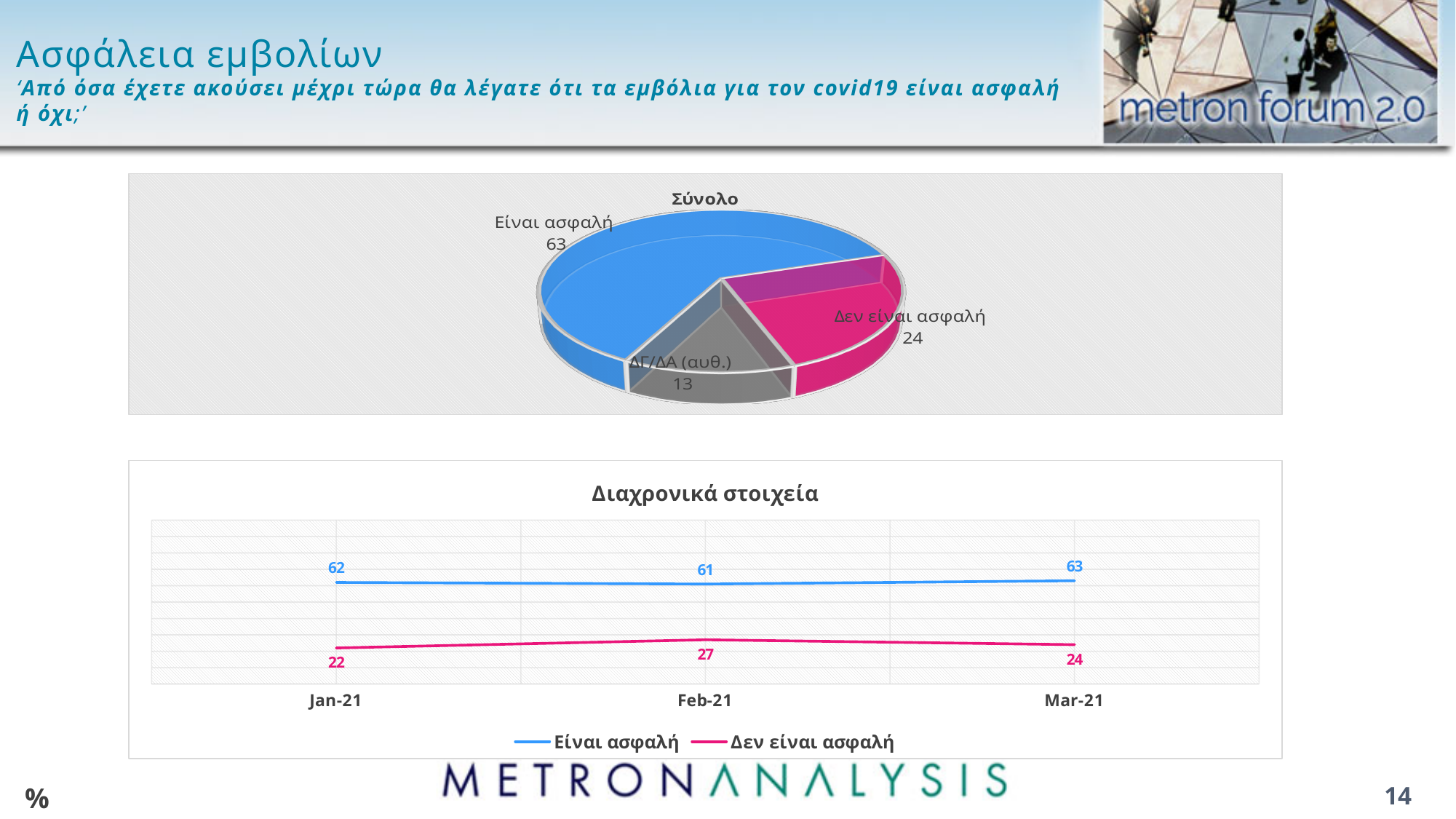
In the chart titled 'Διαχρονικά στοιχεία', what is the value for 'Δεν είναι ασφαλή' in Jan-21? 22 In the chart titled 'Διαχρονικά στοιχεία', what is the difference between 'Είναι ασφαλή' and 'Δεν είναι ασφαλή' in Mar-21? 39 In the chart titled 'Διαχρονικά στοιχεία', what kind of chart is it? Line chart In the pie chart titled 'Σύνολο', what is the difference between 'Είναι ασφαλή' and 'Δεν είναι ασφαλή'? 39 In the pie chart titled 'Σύνολο', how many slices are there? 3 In the pie chart titled 'Σύνολο', which category has the smallest slice? ΔΓ/ΔΑ (αυθ.) In the chart titled 'Διαχρονικά στοιχεία', what is the value for 'Είναι ασφαλή' in Feb-21? 61 In the chart titled 'Διαχρονικά στοιχεία', how many series does the legend list? 2 In the chart titled 'Διαχρονικά στοιχεία', in which month is 'Δεν είναι ασφαλή' highest? Feb-21 In the pie chart titled 'Σύνολο', what is the value for 'ΔΓ/ΔΑ (αυθ.)'? 13 In the pie chart titled 'Σύνολο', which category has the largest slice? Είναι ασφαλή In the pie chart titled 'Σύνολο', what is the value for 'Είναι ασφαλή'? 63